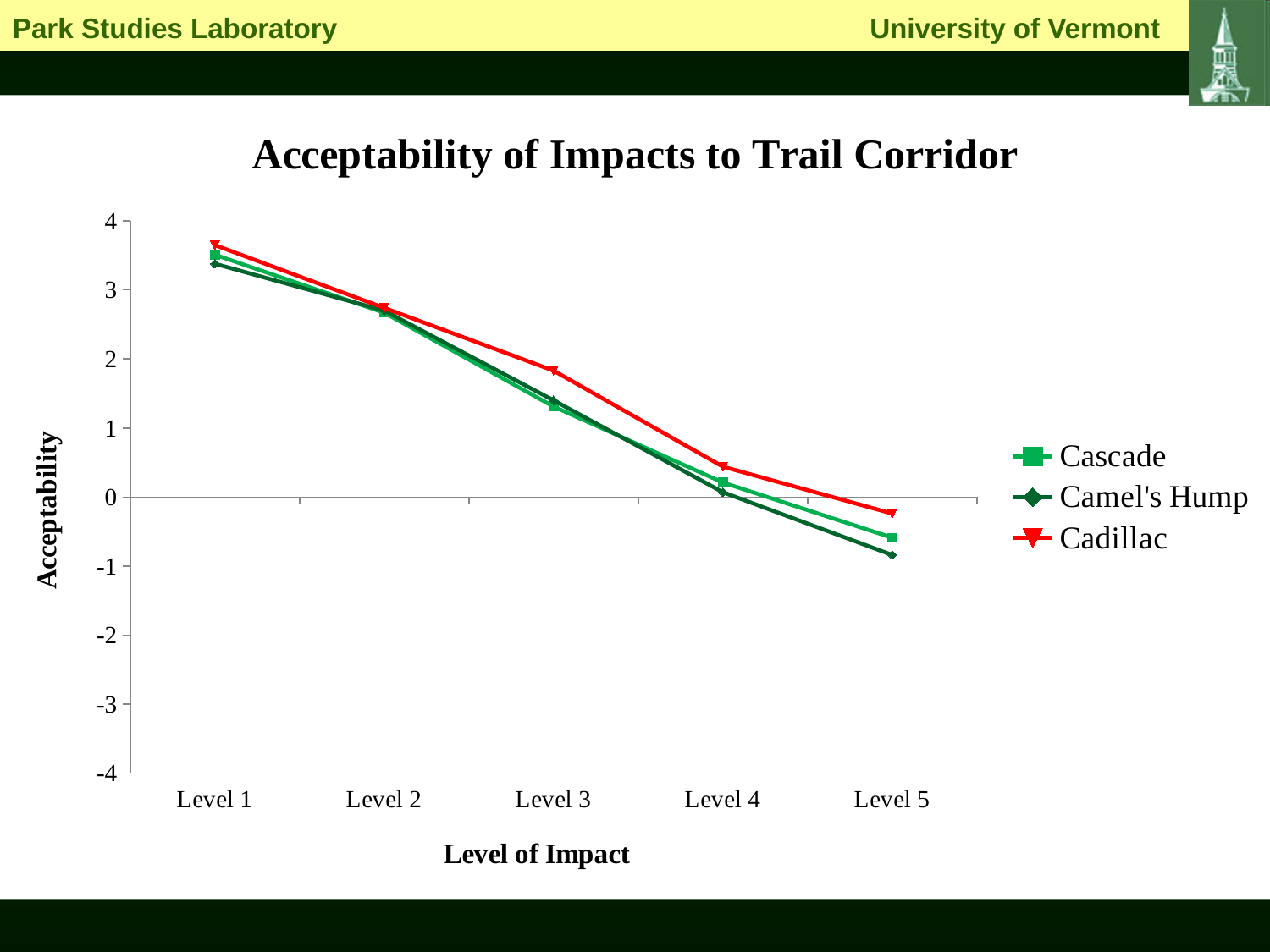
How many series does the legend list? 3 Is the value for Cascade at Level 5 greater or less than 0? less What kind of chart is shown on the slide? Line chart At Level 3, which series has the higher acceptability, Cadillac or Cascade? Cadillac Which series has the lowest acceptability at Level 5? Camel's Hump Do the acceptability values for Cadillac rise or fall from Level 1 to Level 5? Fall Is the value for Cadillac at Level 3 greater or less than 1? greater Which series has the highest acceptability at Level 5? Cadillac Is the value for Cadillac at Level 1 greater or less than 3? greater How many levels of impact are shown on the x axis? 5 What is the title of the chart? Acceptability of Impacts to Trail Corridor